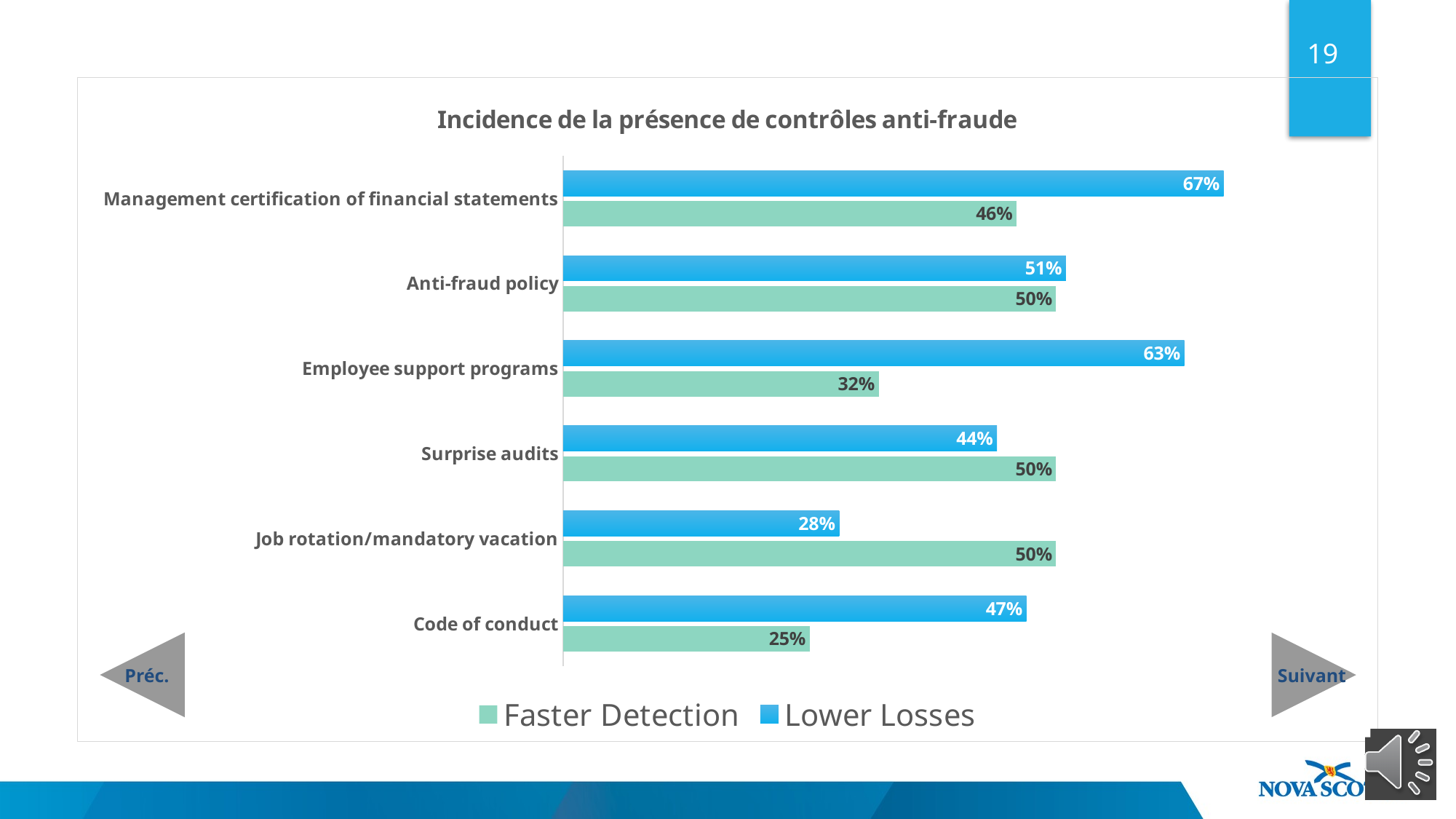
Which category has the lowest Faster Detection value? Code of conduct How many series does the legend list? 2 How many categories are shown on the chart? 6 What is the Lower Losses value for Management certification of financial statements? 67% What kind of chart is shown on the slide? Bar chart Which category has the lowest Lower Losses value? Job rotation/mandatory vacation What is the title of the chart? Incidence de la présence de contrôles anti-fraude Which category has the highest Lower Losses value? Management certification of financial statements For Job rotation/mandatory vacation, which is larger: Faster Detection or Lower Losses? Faster Detection What is the Faster Detection value for Employee support programs? 32% What is the difference between the Lower Losses and Faster Detection values for Employee support programs? 31% What is the Faster Detection value for Code of conduct? 25%